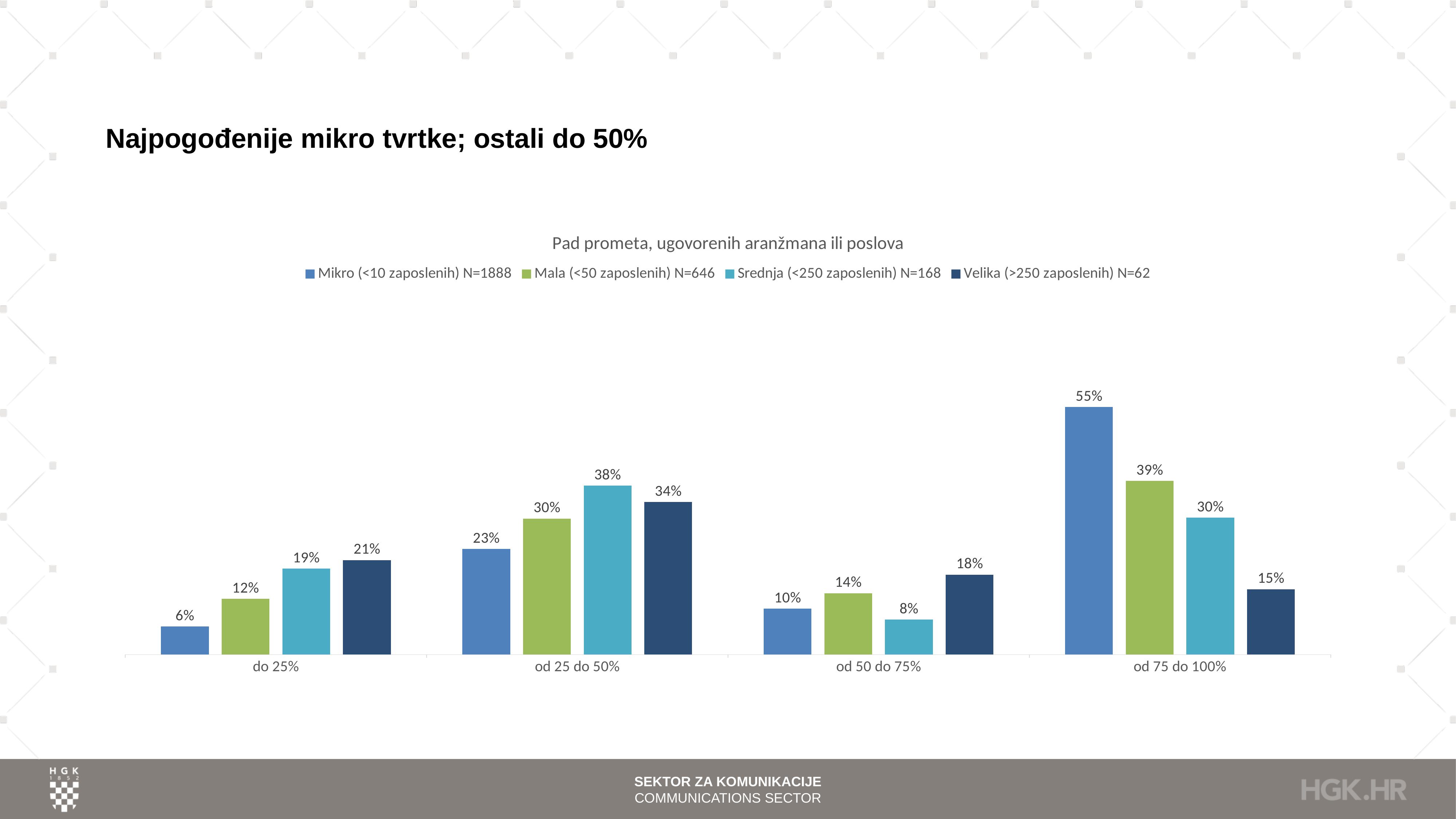
What kind of chart is shown on the slide? Bar chart Which series has the lowest value in the 'od 50 do 75%' category? Srednja (<250 zaposlenih) N=168 What is the value for Srednja (<250 zaposlenih) in the 'od 25 do 50%' category? 38% What is the sample size (N) given in the legend for the Mala (<50 zaposlenih) series? 646 What is the value for Velika (>250 zaposlenih) in the 'do 25%' category? 21% Which is larger in the 'od 25 do 50%' category: Mala (<50 zaposlenih) or Velika (>250 zaposlenih)? Velika (>250 zaposlenih) Which series has the highest value in the 'od 75 do 100%' category? Mikro (<10 zaposlenih) N=1888 What is the difference between the Mikro and Velika values in the 'od 75 do 100%' category? 40% How many series does the legend list? 4 What is the value for Mikro (<10 zaposlenih) in the 'od 75 do 100%' category? 55% How many categories are shown on the x axis? 4 What is the title of the chart? Pad prometa, ugovorenih aranžmana ili poslova